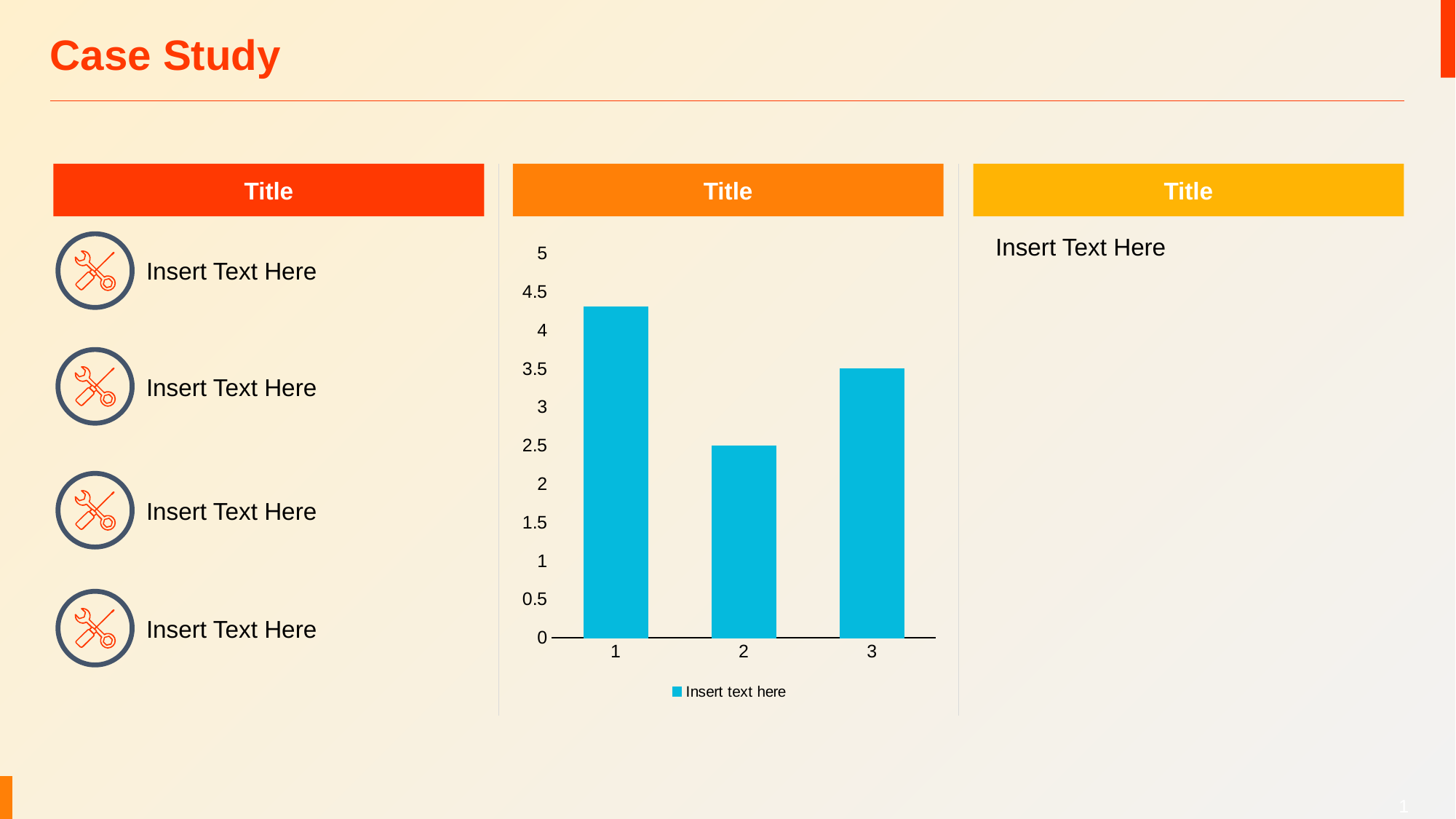
How many series does the chart legend list? 1 Is the value for category 1 greater or less than 4? greater What kind of chart is shown on the slide? bar chart What is the value for category 2? 2.5 What is the legend entry shown below the chart? Insert text here What is the value for category 3? 3.5 What is the difference between the values for category 3 and category 2? 1 Which category has the lowest bar? 2 How many categories are plotted on the x axis of the bar chart? 3 Which category has the highest bar? 1 Which is larger, the value for category 2 or category 3? 3 Which is larger, the value for category 1 or category 3? 1